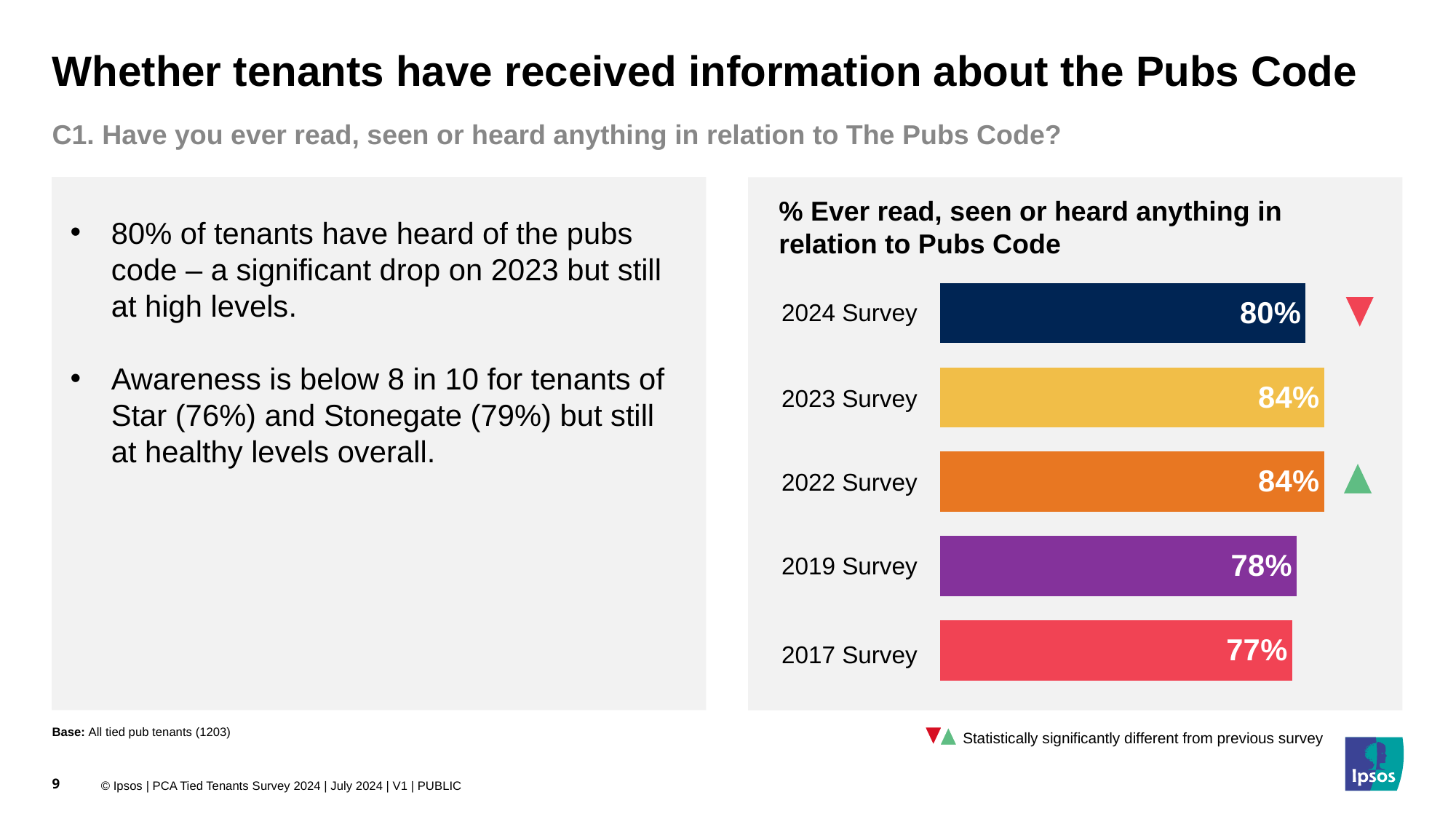
What kind of chart is shown on the slide? Bar chart How many survey years are shown in the chart? 5 What is the title of the chart? % Ever read, seen or heard anything in relation to Pubs Code What is the difference between the 2023 Survey and the 2024 Survey values? 4% Which survey year has the lowest value? 2017 Survey Which is larger, the value for the 2022 Survey or the 2019 Survey? 2022 Survey What is the value for the 2017 Survey? 77% What is the value for the 2019 Survey? 78% Do the values for the 2022 Survey and the 2023 Survey differ? No, both are 84% What is the value for the 2024 Survey? 80% What colour is the bar for the 2019 Survey? Purple What is the difference between the 2019 Survey and the 2017 Survey values? 1%